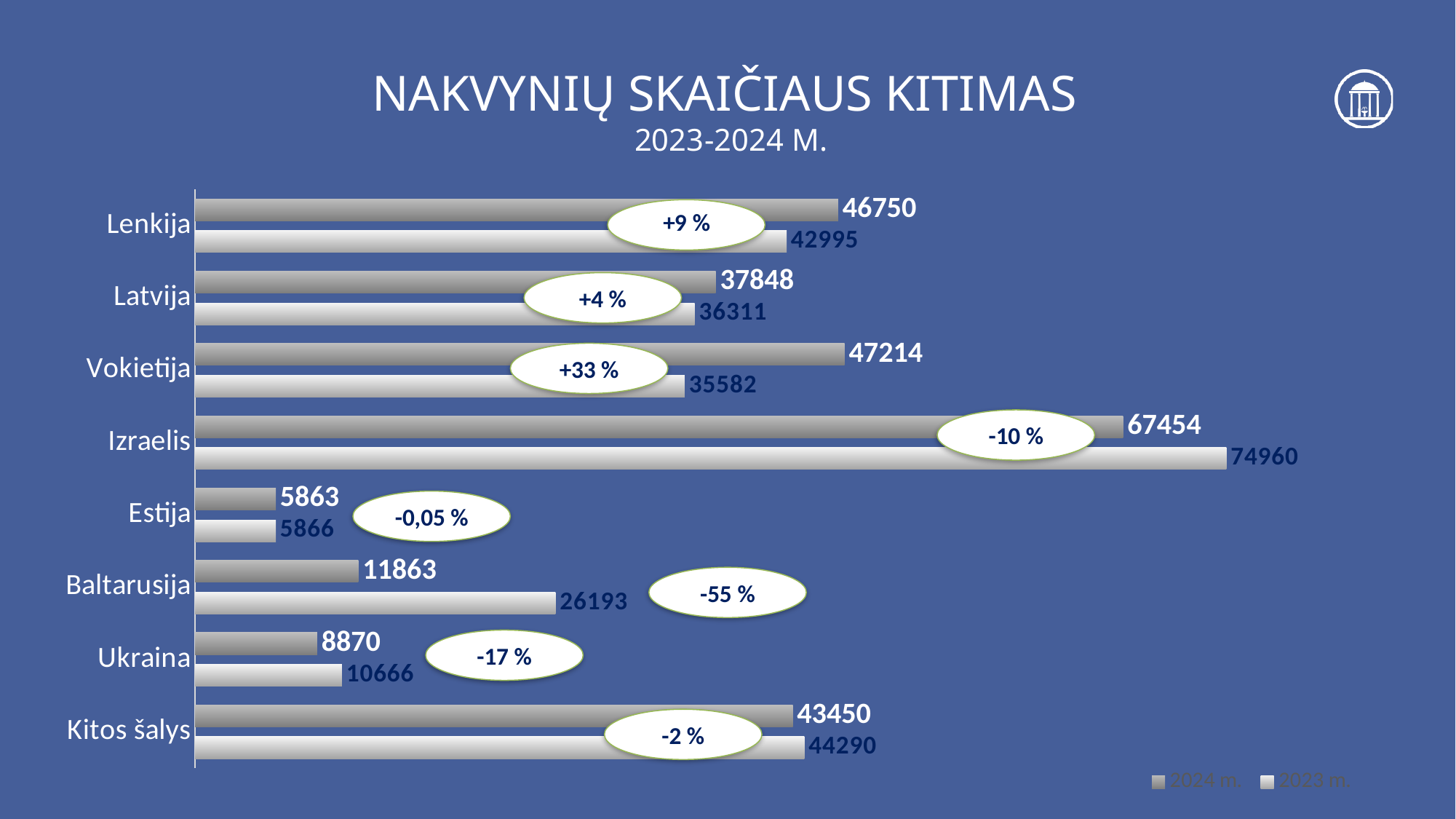
Which category has the highest 2024 m. value? Izraelis How many categories (countries/groups) are shown on the chart? 8 What is the difference between the 2024 m. and 2023 m. values for Vokietija? 11632 How many series does the legend list? 2 Which category has the lowest 2023 m. value? Estija What is the 2024 m. value for Lenkija? 46750 Which is larger for Baltarusija: the 2024 m. value or the 2023 m. value? 2023 m. What is the title of the chart? NAKVYNIŲ SKAIČIAUS KITIMAS 2023-2024 M. What kind of chart is shown on the slide? bar chart What is the 2023 m. value for Izraelis? 74960 What percentage change is shown in the oval label for Baltarusija? -55 % What is the 2024 m. value for Ukraina? 8870